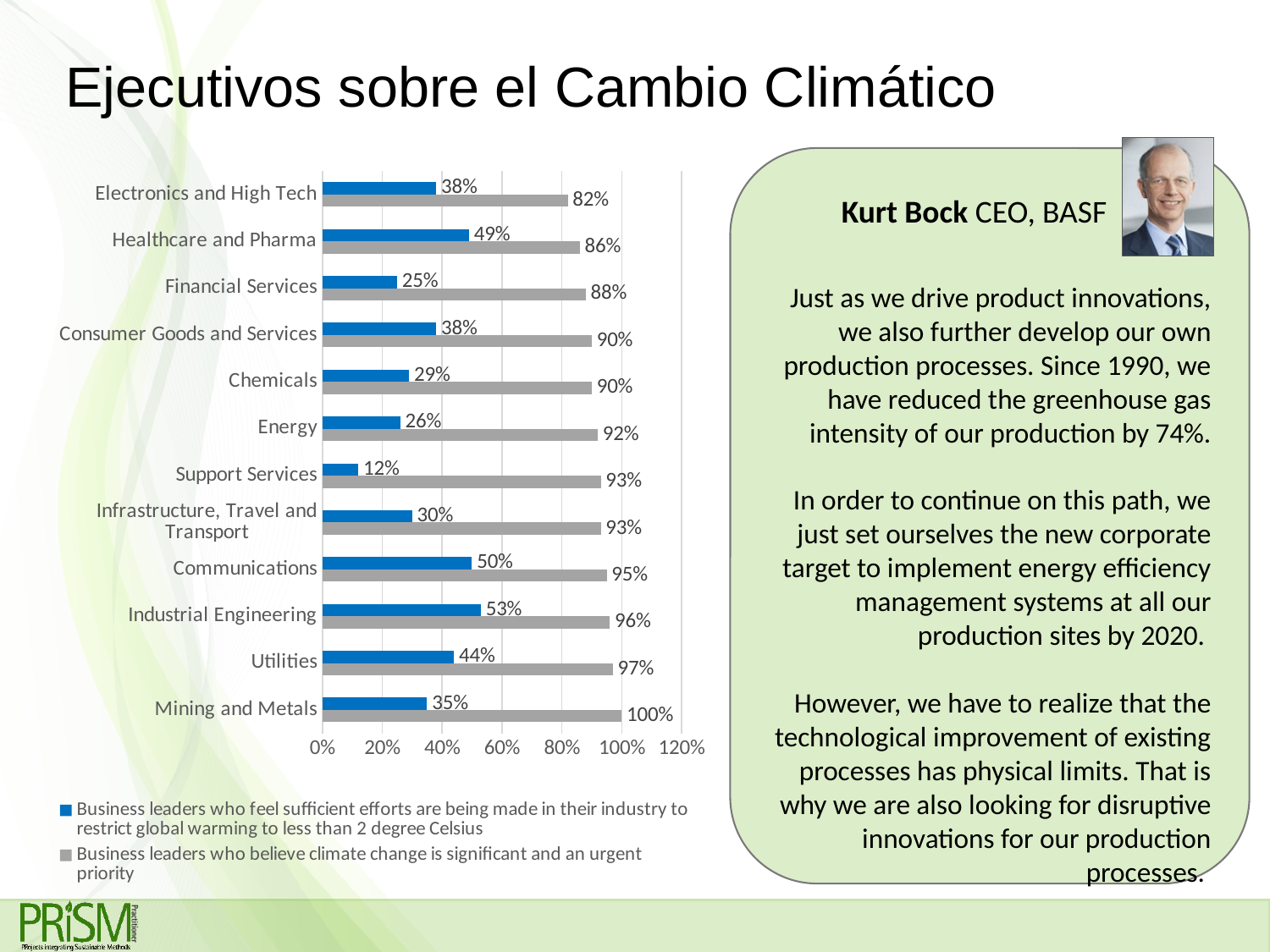
Which has a higher value for business leaders who feel sufficient efforts are being made: Healthcare and Pharma or Chemicals? Healthcare and Pharma Which industry has the highest share of business leaders who feel sufficient efforts are being made to restrict global warming? Industrial Engineering What is the difference between the two series values for Utilities? 53% How many industry categories are plotted in the chart? 12 What percentage of business leaders in Mining and Metals believe climate change is significant and an urgent priority? 100% What kind of chart is shown on the slide? bar chart Is the value for Communications in the 'sufficient efforts' series greater or less than 40%? greater What is the value for Financial Services in the series 'Business leaders who believe climate change is significant and an urgent priority'? 88% Which industry has the lowest share of business leaders who believe climate change is significant and an urgent priority? Electronics and High Tech How many series does the chart legend list? 2 Which colour represents the series 'Business leaders who believe climate change is significant and an urgent priority'? gray What percentage of business leaders in Support Services feel sufficient efforts are being made in their industry to restrict global warming to less than 2 degree Celsius? 12%